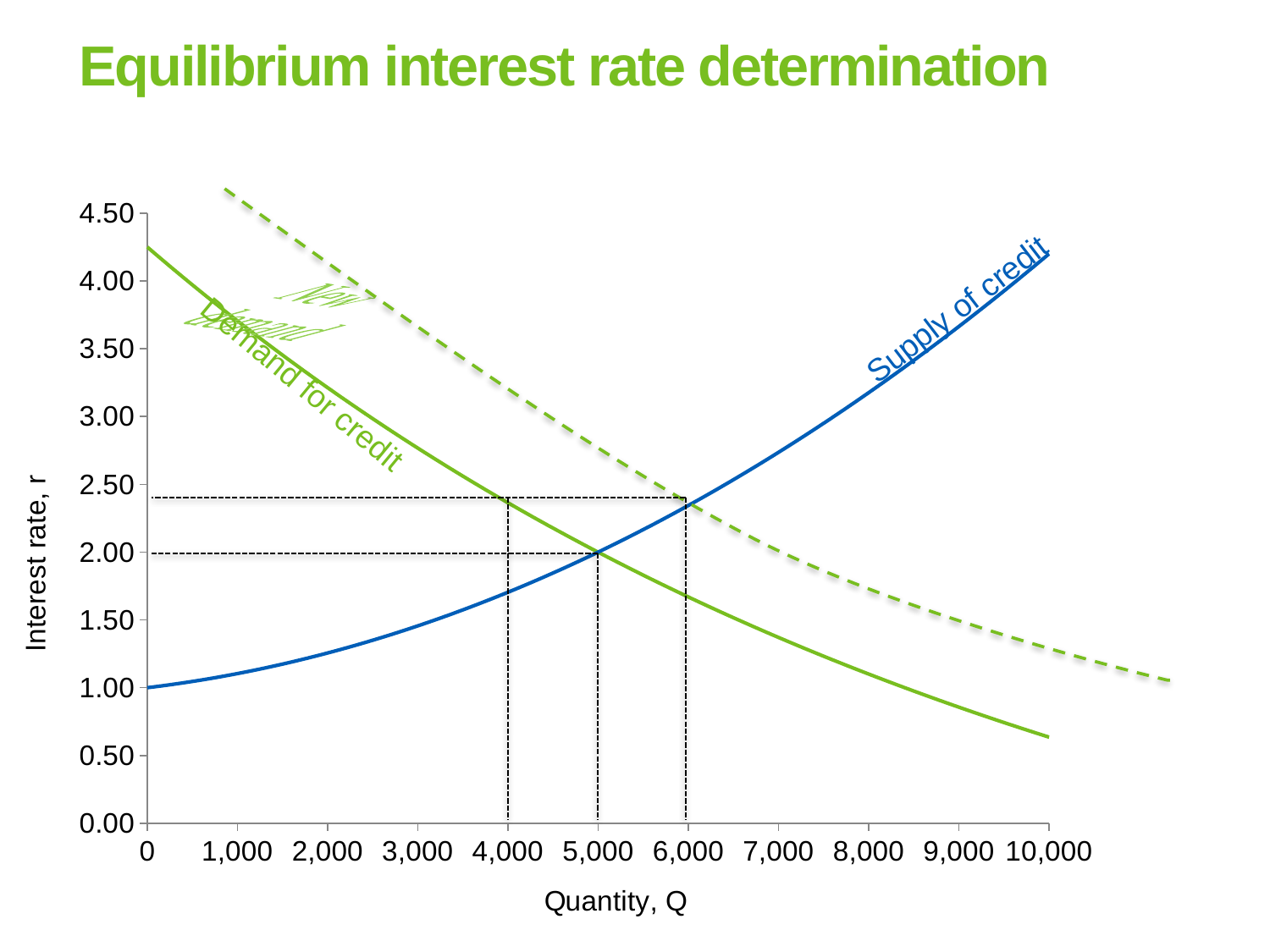
What is the label of the x axis? Quantity, Q What is the interest rate at the intersection of the Demand for credit and Supply of credit curves? 2.00 Does the Demand for credit curve rise or fall as quantity increases? falls Is the interest rate on the Supply of credit curve at a quantity of 10,000 greater or less than 4.00? greater What kind of chart is shown on the slide? line chart Is the interest rate on the Demand for credit curve at a quantity of 10,000 greater or less than 1.00? less At what quantity do the Demand for credit and Supply of credit curves intersect? 5,000 At a quantity of 2,000, which curve shows the higher interest rate, Demand for credit or Supply of credit? Demand for credit Does the Supply of credit curve rise or fall as quantity increases? rises What is the interest rate on the Supply of credit curve at a quantity of 0? 1.00 Is the interest rate on the Demand for credit curve at a quantity of 0 greater or less than 4.00? greater What is the title of the slide's chart? Equilibrium interest rate determination